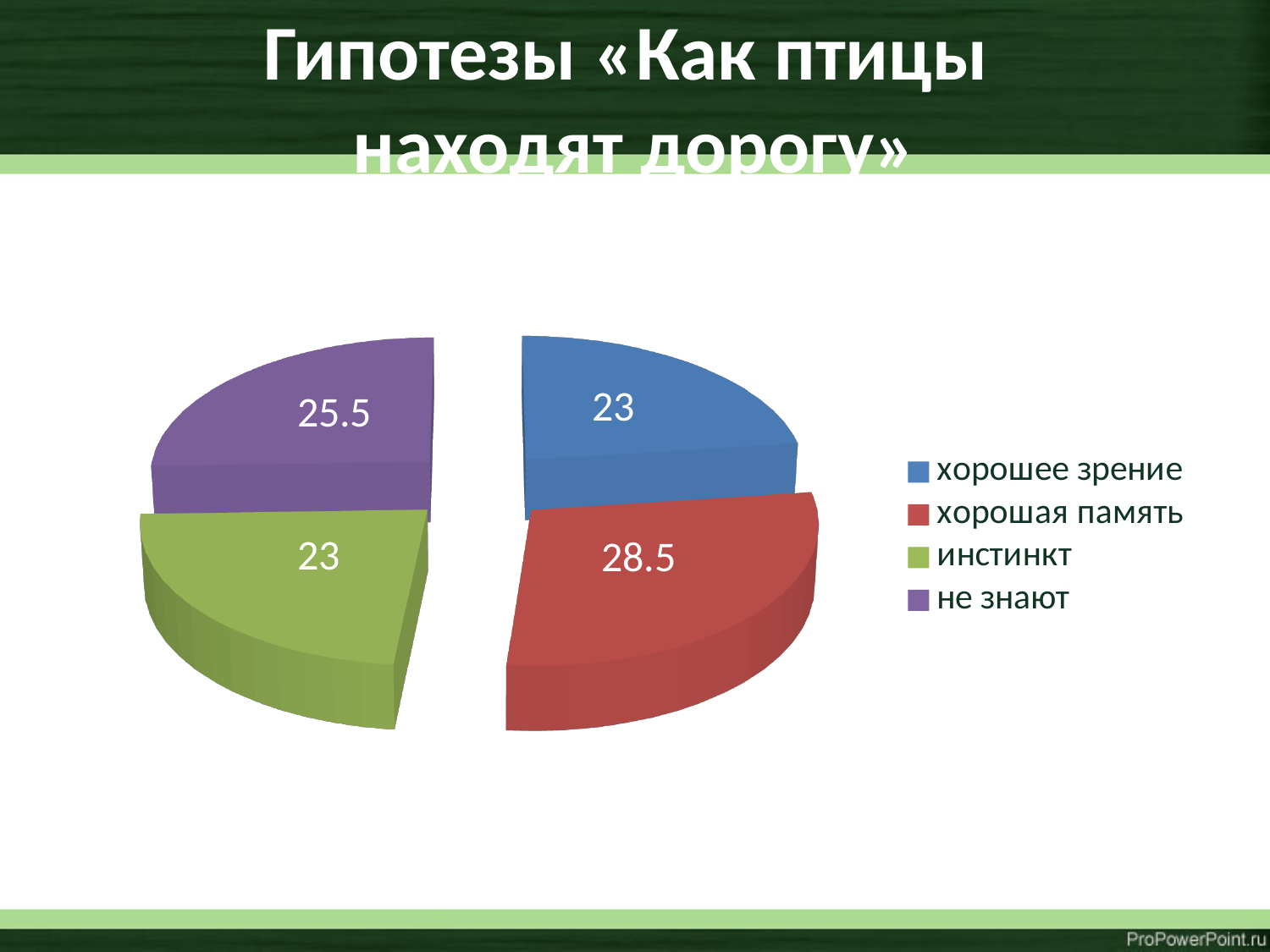
How many slices does the pie chart have? 4 What is the value for «хорошее зрение»? 23 What colour is the slice for «инстинкт»? green What is the difference between the values for «хорошая память» and «инстинкт»? 5.5 What kind of chart is shown on the slide? pie chart How many entries does the legend list? 4 What is the difference between the values for «хорошая память» and «не знают»? 3 What is the value for «инстинкт»? 23 Which is larger, the value for «не знают» or the value for «хорошее зрение»? не знают What is the value for «хорошая память»? 28.5 Which category has the largest slice of the pie? хорошая память What is the value for «не знают»? 25.5